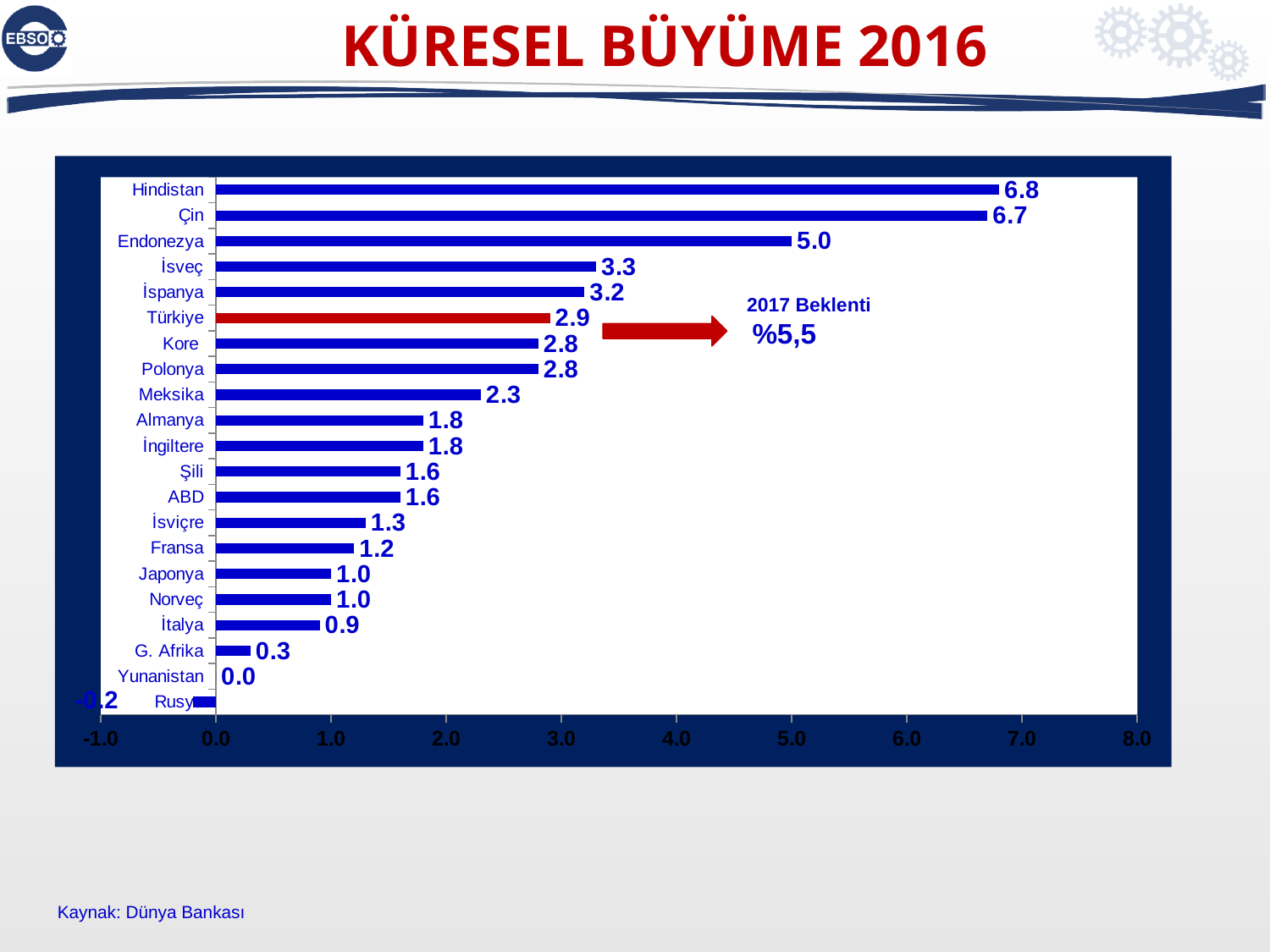
What kind of chart is shown on the slide? bar chart What is the difference between the values for Hindistan and Çin? 0.1 What is the value for Endonezya? 5.0 Which country has the lowest value? Rusya What is the value for Türkiye? 2.9 What is the 2017 expectation (2017 Beklenti) shown next to the Türkiye bar? %5,5 What is the difference between the values for Türkiye and Meksika? 0.6 What is the value for Hindistan? 6.8 Is the value for Endonezya greater or less than 4.0? greater How many countries are shown in the chart? 21 Which country has the highest value? Hindistan Which is larger, the value for İsveç or the value for Almanya? İsveç